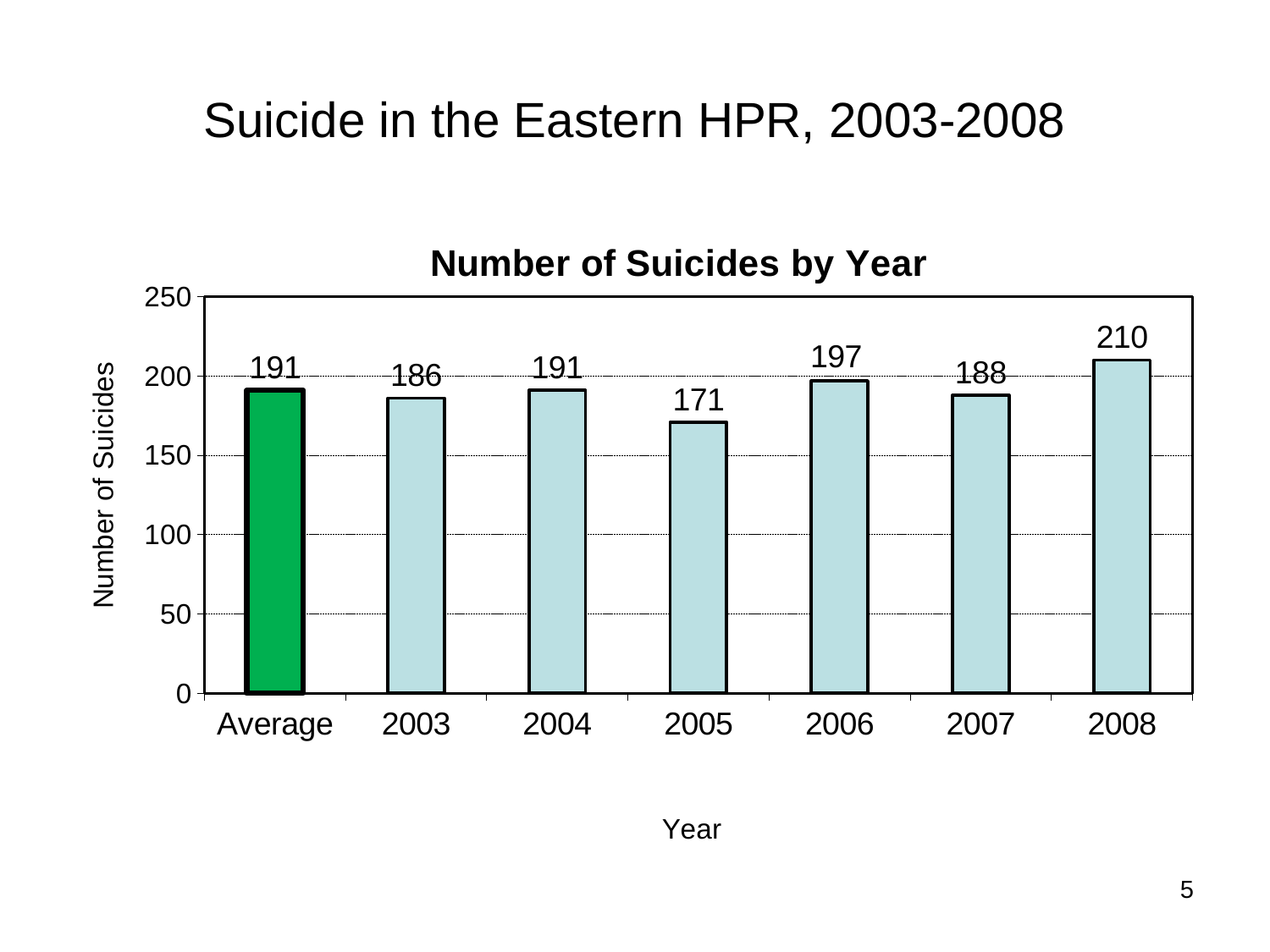
What value is shown for the Average bar? 191 What is the difference between the number of suicides in 2006 and in 2003? 11 Which is larger, the value for 2006 or the value for 2007? 2006 Is the value for 2005 greater or less than 200? less What kind of chart is shown on the slide? bar chart What is the title of the chart? Number of Suicides by Year What is the number of suicides shown for 2005? 171 How many bars are shown in the chart? 7 What is the number of suicides shown for 2008? 210 Which year has the lowest number of suicides? 2005 What is the difference between the number of suicides in 2008 and in 2005? 39 Which year has the highest number of suicides? 2008